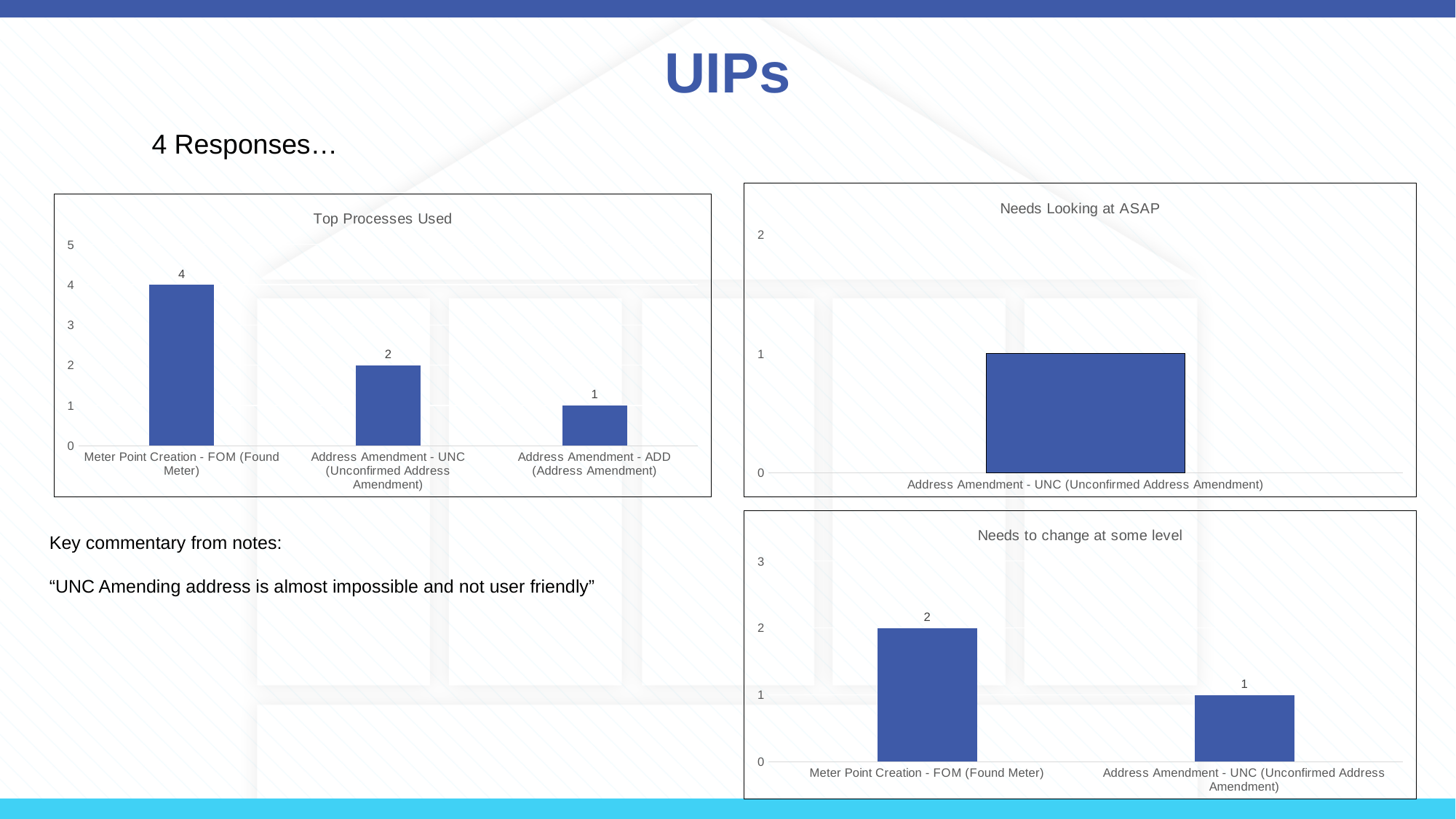
In the 'Top Processes Used' chart, which category has the highest value? Meter Point Creation - FOM (Found Meter) In the 'Top Processes Used' chart, which category has the lowest value? Address Amendment - ADD (Address Amendment) How many categories are shown in the 'Needs Looking at ASAP' chart? 1 In the 'Needs to change at some level' chart, which is larger: Meter Point Creation - FOM (Found Meter) or Address Amendment - UNC (Unconfirmed Address Amendment)? Meter Point Creation - FOM (Found Meter) What is the title of the chart in the bottom right of the slide? Needs to change at some level In the 'Needs to change at some level' chart, what is the value for Meter Point Creation - FOM (Found Meter)? 2 What kind of chart is 'Top Processes Used'? Bar chart In the 'Top Processes Used' chart, do the values rise or fall from left to right? Fall In the 'Top Processes Used' chart, what is the value for Address Amendment - ADD (Address Amendment)? 1 In the 'Top Processes Used' chart, what is the difference between Meter Point Creation - FOM (Found Meter) and Address Amendment - UNC (Unconfirmed Address Amendment)? 2 How many categories are shown in the 'Top Processes Used' chart? 3 In the 'Top Processes Used' chart, what is the value for Meter Point Creation - FOM (Found Meter)? 4